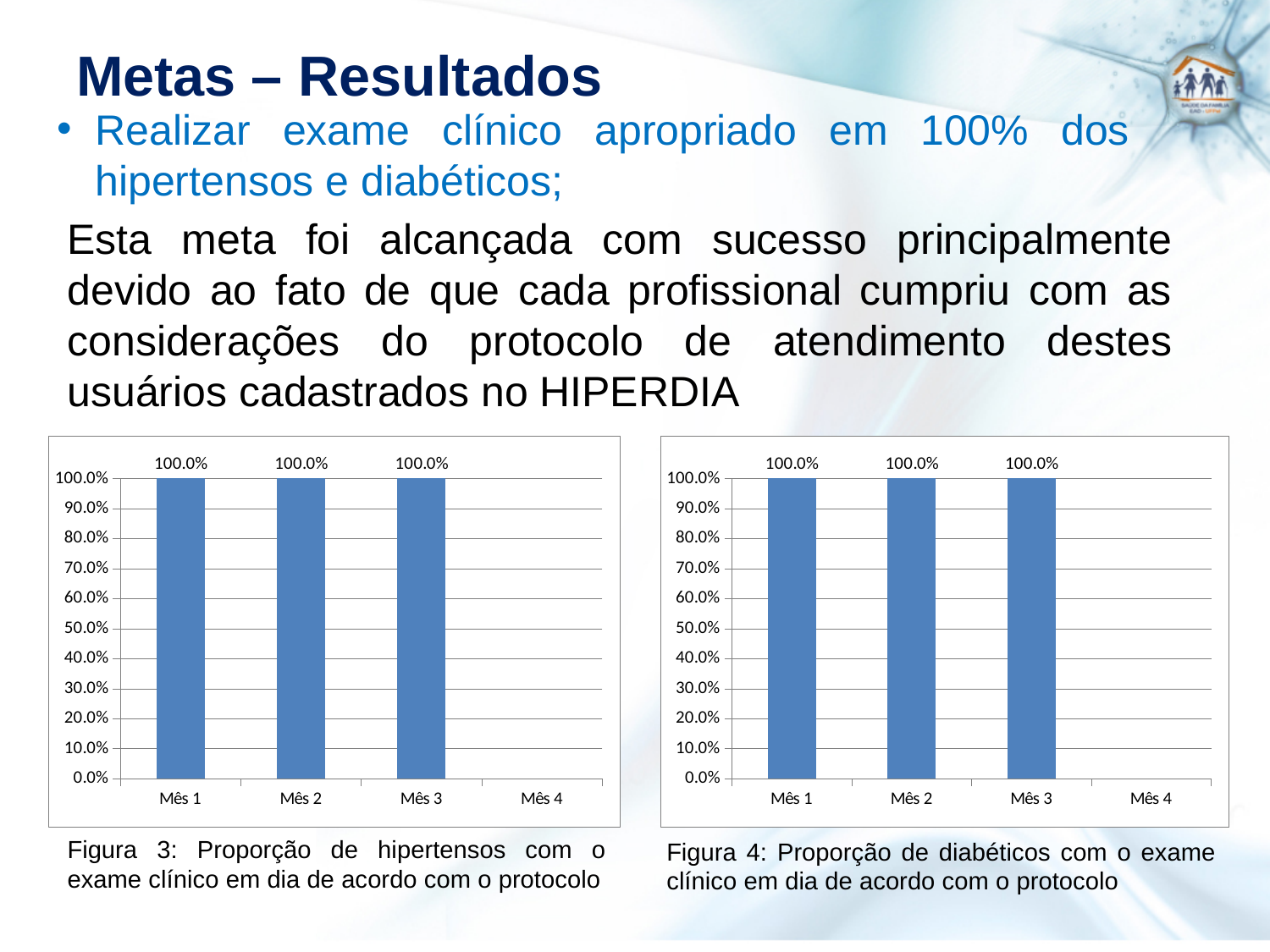
In the right chart (Figura 4), what is the value for Mês 3? 100.0% In the right chart (Figura 4), what is the value for Mês 2? 100.0% In the left chart (Figura 3), which category has no bar plotted? Mês 4 In the right chart (Figura 4), do the values rise, fall or stay the same from Mês 1 to Mês 3? Stay the same In the left chart (Figura 3), what is the value for Mês 3? 100.0% In the left chart (Figura 3), what is the value for Mês 1? 100.0% In the left chart (Figura 3), what is the difference between the values for Mês 1 and Mês 2? 0.0% What is the highest value shown on the y axis of the right chart (Figura 4)? 100.0% How many categories are shown on the x axis of the left chart (Figura 3)? 4 How many categories are shown on the x axis of the right chart (Figura 4)? 4 In the right chart (Figura 4), is the value for Mês 1 greater or less than 90.0%? greater What kind of chart is the left chart (Figura 3)? Bar chart